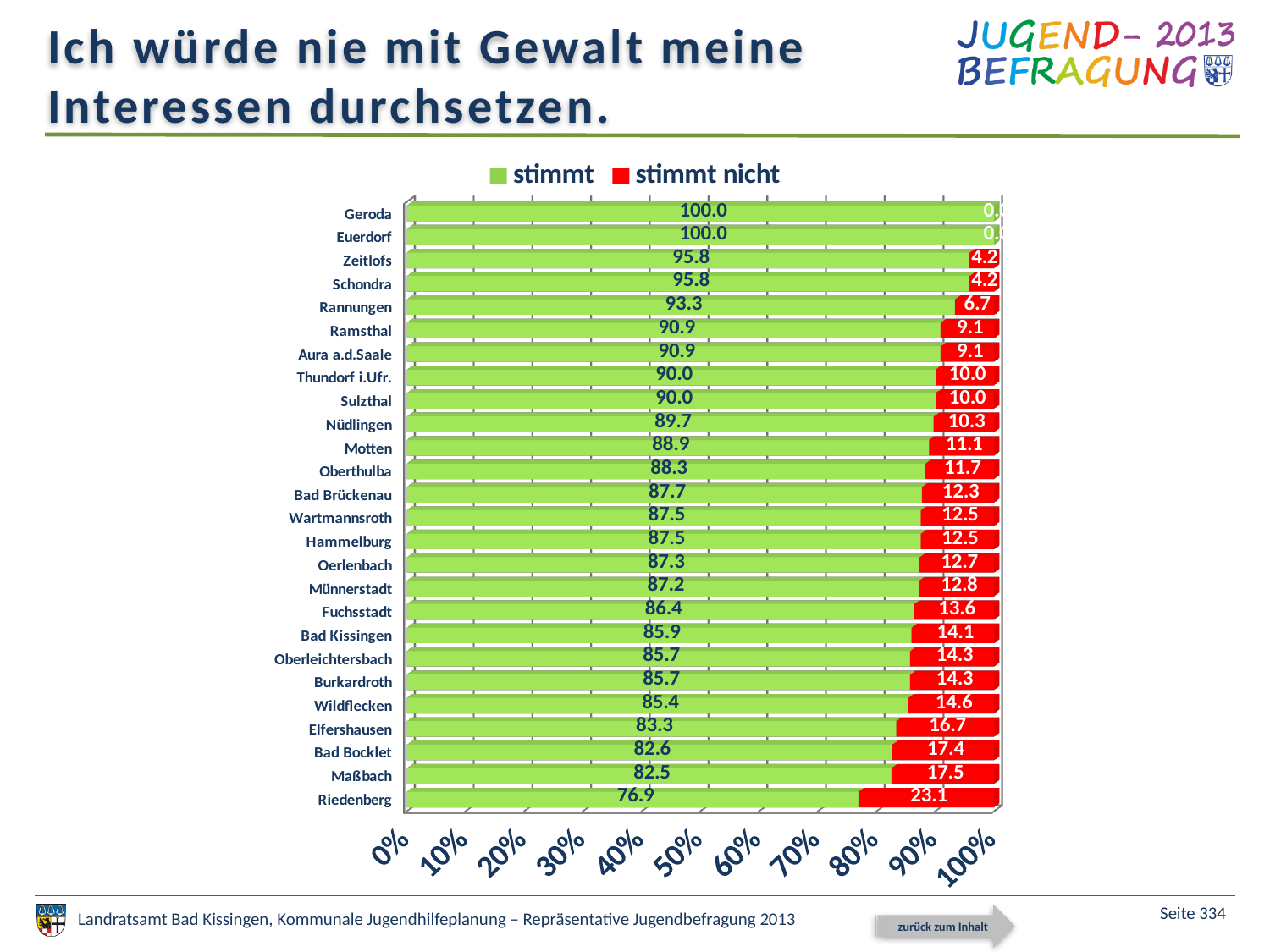
What kind of chart is shown on the slide? Stacked bar chart How many series does the legend list? 2 What is the total of the stacked bar for Maßbach? 100.0 What is the "stimmt" value for Riedenberg? 76.9 Which category has the lowest "stimmt" value? Riedenberg How many categories (municipalities) are shown on the chart? 26 Which colour represents the "stimmt nicht" series? Red What is the difference between the "stimmt" values for Zeitlofs and Riedenberg? 18.9 Which has a larger "stimmt nicht" value, Motten or Elfershausen? Elfershausen Which category has the highest "stimmt nicht" value? Riedenberg What is the "stimmt nicht" value for Rannungen? 6.7 What is the "stimmt" value for Bad Kissingen? 85.9